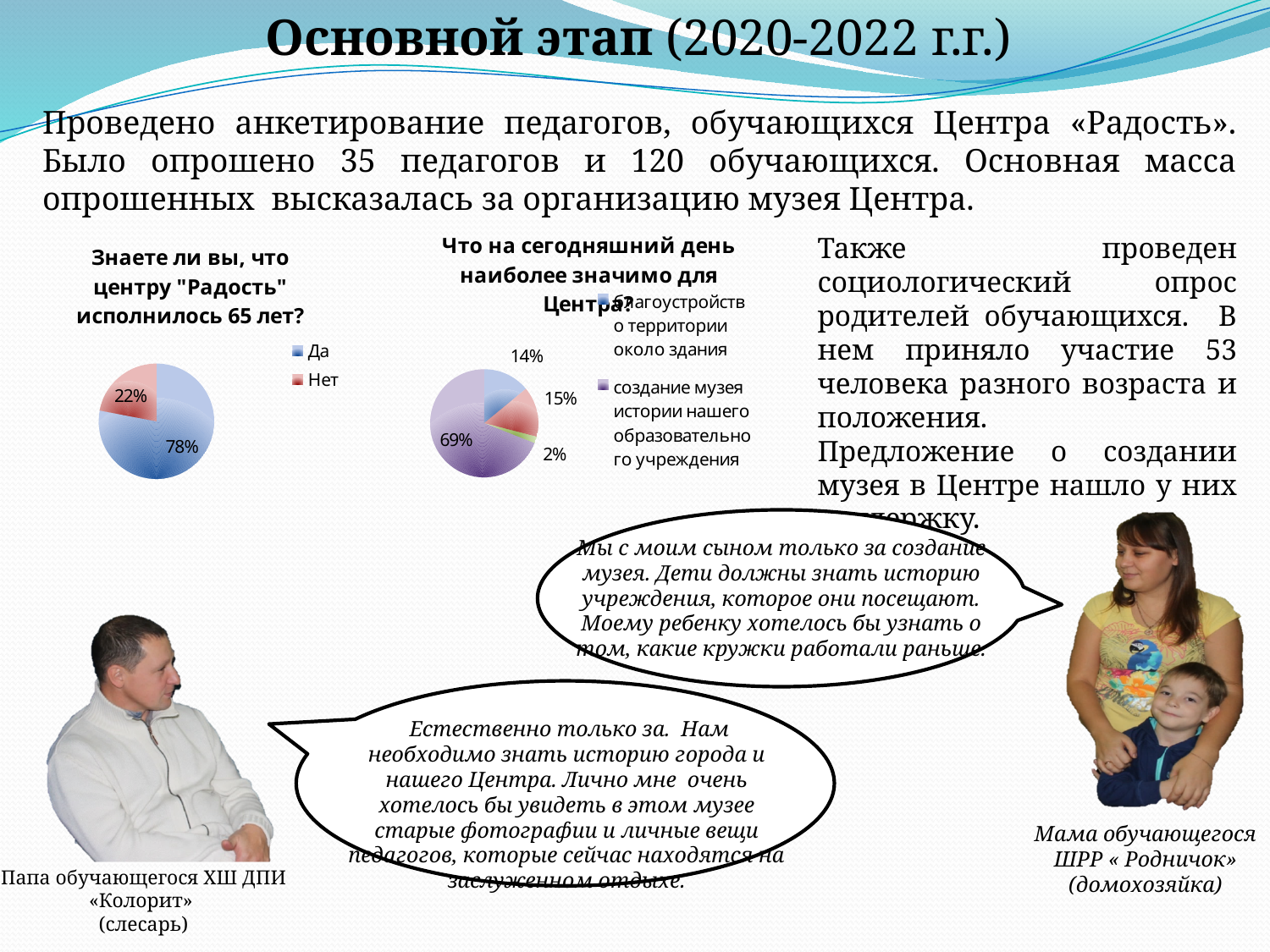
How many slices does the pie chart titled "Что на сегодняшний день наиболее значимо для Центра?" have? 4 In the pie chart titled "Что на сегодняшний день наиболее значимо для Центра?", what share corresponds to "создание музея истории нашего образовательного учреждения"? 69% In the pie chart titled "Что на сегодняшний день наиболее значимо для Центра?", what share corresponds to "благоустройство территории около здания"? 14% In the pie chart titled "Что на сегодняшний день наиболее значимо для Центра?", what is the smallest slice's value? 2% In the pie chart titled "Знаете ли вы, что центру "Радость" исполнилось 65 лет?", what percentage answered "Да"? 78% In the pie chart titled "Что на сегодняшний день наиболее значимо для Центра?", what is the largest slice's value? 69% In the pie chart titled "Знаете ли вы, что центру "Радость" исполнилось 65 лет?", what percentage answered "Нет"? 22% How many pie charts are shown on the slide? 2 In the pie chart titled "Знаете ли вы, что центру "Радость" исполнилось 65 лет?", what is the difference in percentage points between "Да" and "Нет"? 56 How many entries does the legend of the pie chart titled "Знаете ли вы, что центру "Радость" исполнилось 65 лет?" list? 2 In the pie chart titled "Знаете ли вы, что центру "Радость" исполнилось 65 лет?", which answer has the larger share? Да What type of chart is the chart titled "Знаете ли вы, что центру "Радость" исполнилось 65 лет?"? Pie chart